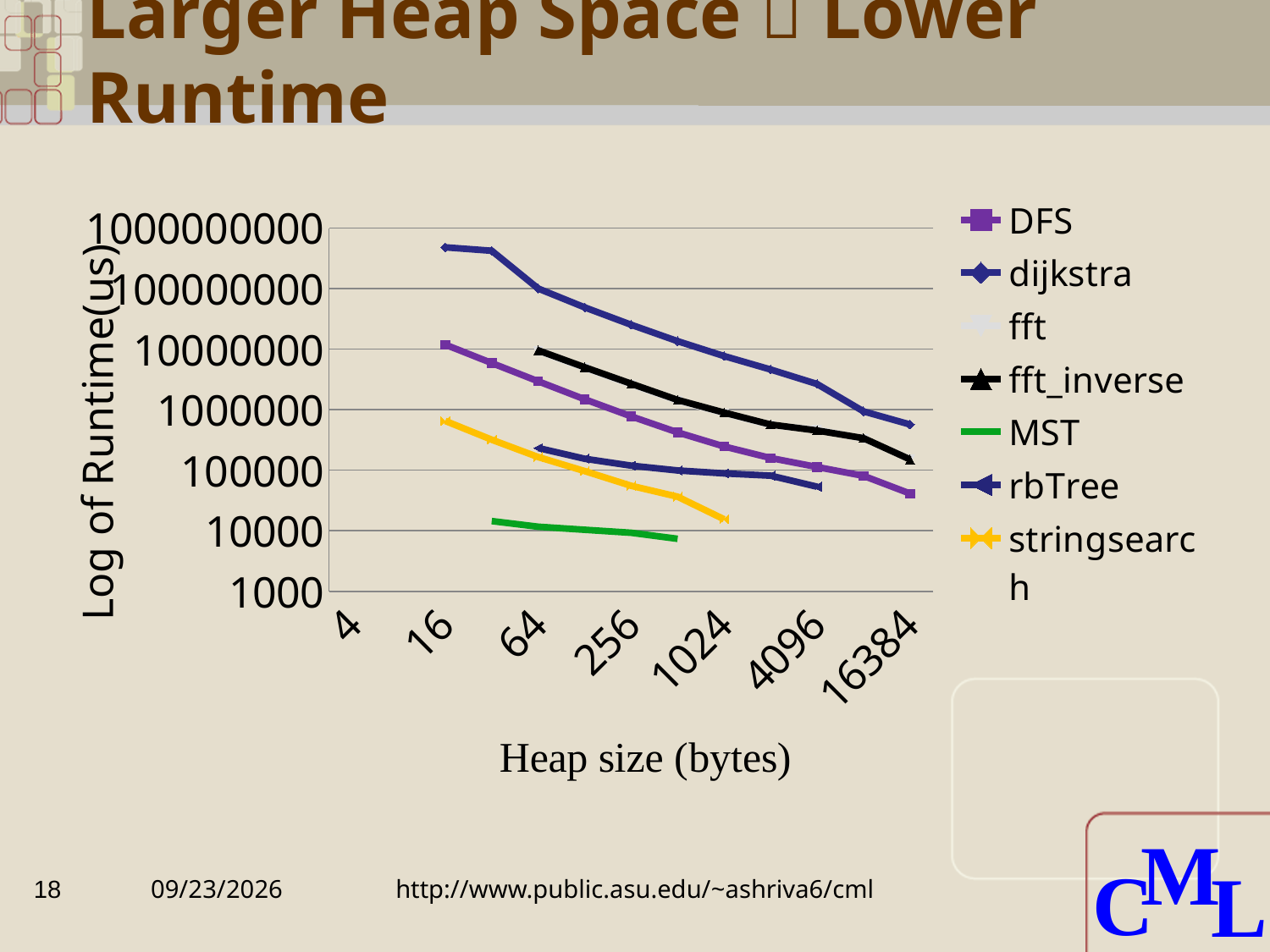
Is the value for dijkstra at heap size 16 greater or less than 100000000? greater Is the value for stringsearch at heap size 16 greater or less than 1000000? less What is the label of the y axis? Log of Runtime(us) What kind of chart is shown on the slide? line chart How many series does the legend list? 7 How many tick labels are shown on the x axis (Heap size)? 7 Which series has the lowest runtime values on the chart? MST Do the runtime values rise or fall as heap size increases along the x axis? fall What is the label of the x axis? Heap size (bytes) Which series has the highest runtime values on the chart? dijkstra Is the value for DFS at heap size 16384 greater or less than 100000? less At heap size 256, which series has the larger runtime, dijkstra or DFS? dijkstra